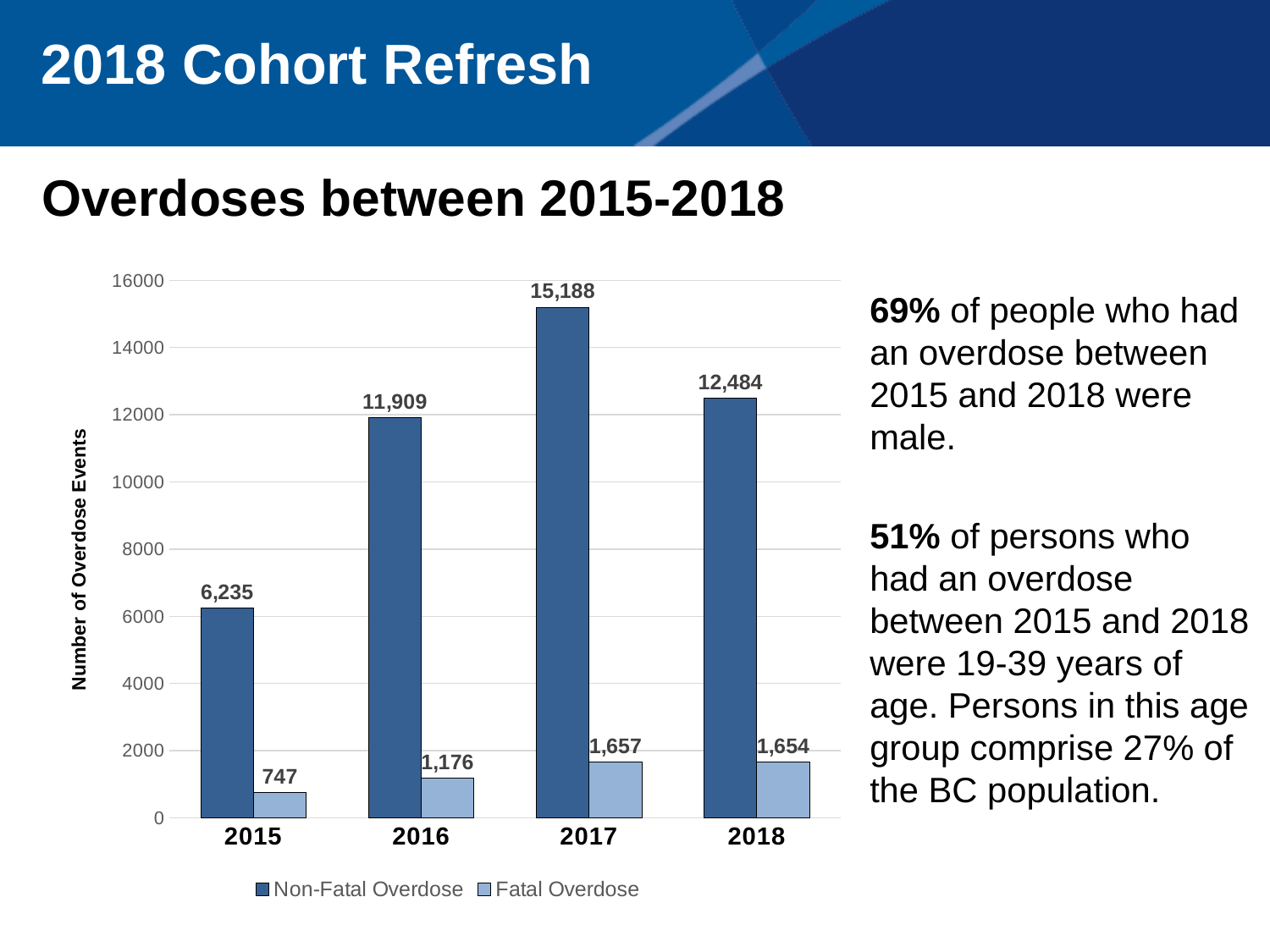
What is the number of fatal overdose events in 2016? 1,176 Is the number of non-fatal overdose events in 2015 greater or less than 8000? less How many years are shown on the x axis of the chart? 4 What type of chart is used to show the overdose events? bar chart Which year has the highest number of non-fatal overdose events? 2017 What is the difference between non-fatal overdose events in 2017 and 2018? 2,704 Which is larger, the number of non-fatal overdose events in 2016 or in 2018? 2018 What is the number of fatal overdose events in 2015? 747 How many series does the chart legend list? 2 What is the number of non-fatal overdose events in 2017? 15,188 What is the difference between fatal overdose events in 2016 and 2015? 429 Which year has the lowest number of fatal overdose events? 2015